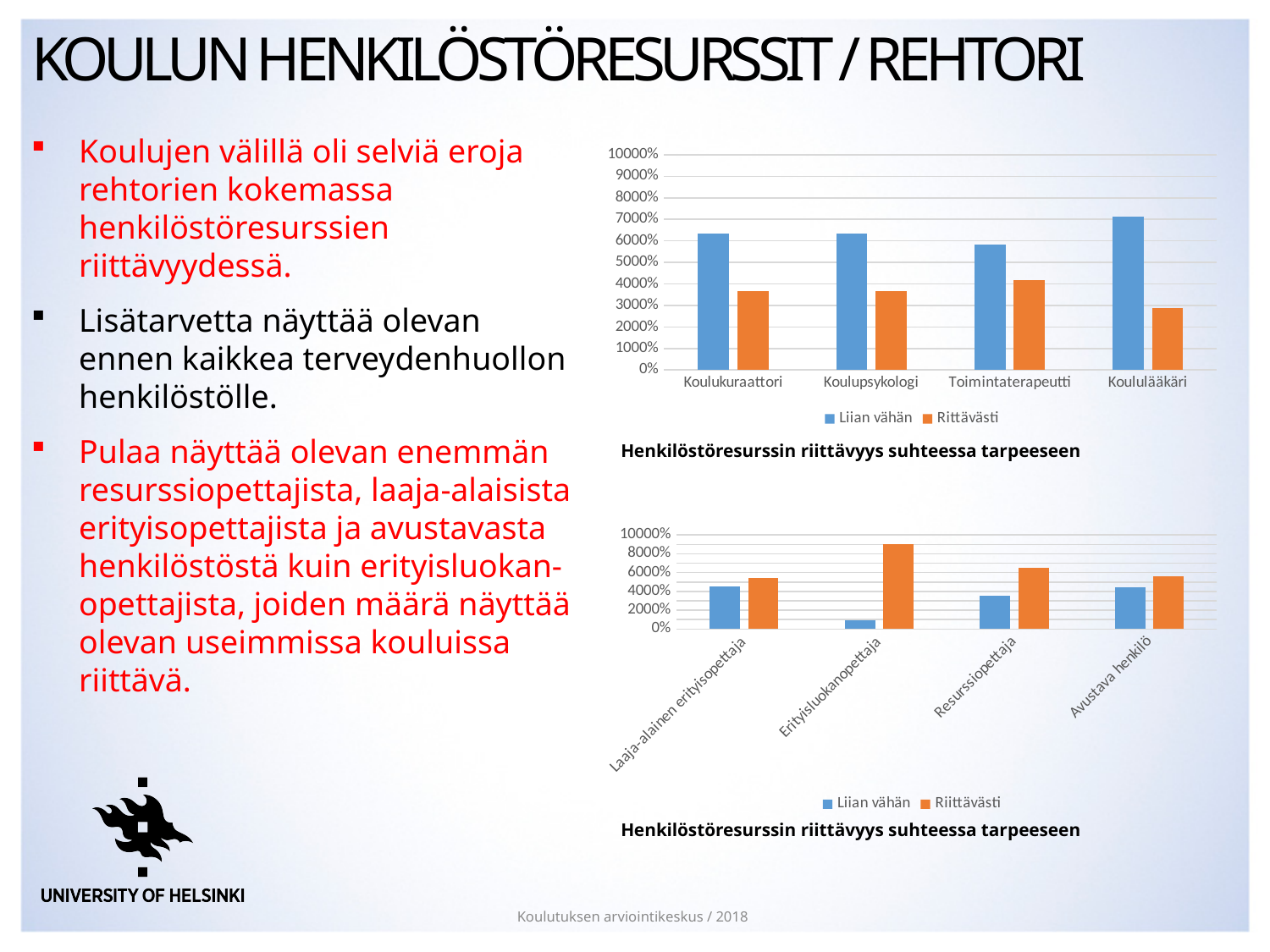
In the bottom chart, which category has the lowest value for Liian vähän? Erityisluokanopettaja In the top chart, which is larger for Toimintaterapeutti: Liian vähän or Riittävästi? Liian vähän In the top chart, is the Liian vähän value for Koululääkäri greater or less than 6000%? greater In the bottom chart, which is larger for Resurssiopettaja: Liian vähän or Riittävästi? Riittävästi In the top chart, which category has the highest value for Liian vähän? Koululääkäri In the bottom chart, which category has the highest value for Riittävästi? Erityisluokanopettaja In the top chart, which category has the lowest value for Riittävästi? Koululääkäri How many categories are shown on the x axis of the top chart? 4 In the bottom chart, is the Riittävästi value for Erityisluokanopettaja greater or less than 8000%? greater In the top chart, which colour represents the Riittävästi series? orange What kind of chart is the top chart on the slide? bar chart How many series does the legend of the bottom chart list? 2